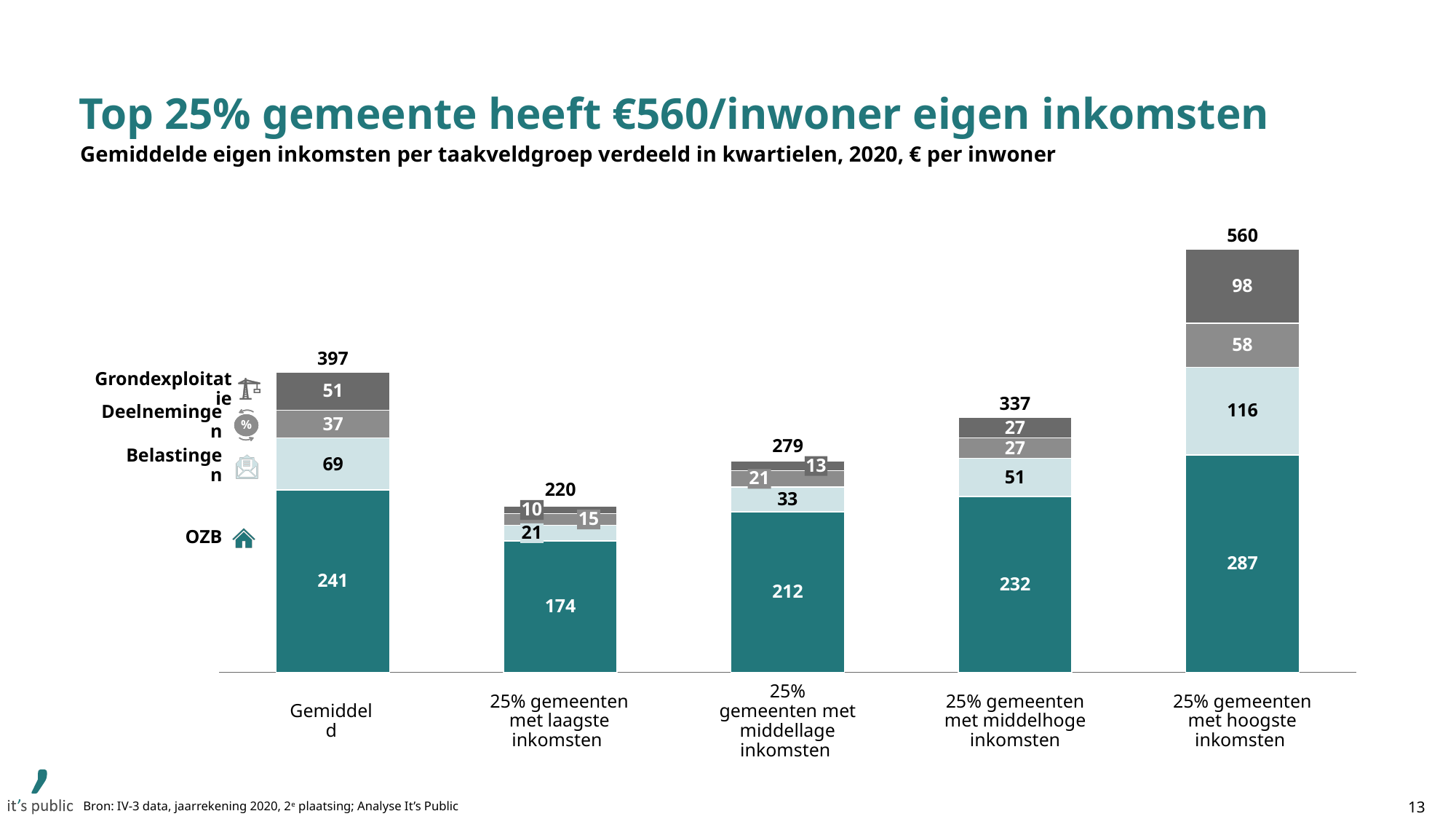
What is the Belastingen value for 'Gemiddeld'? 69 Do the bar totals rise or fall from the lowest-income quartile to the highest-income quartile? Rise Which category has the highest total? 25% gemeenten met hoogste inkomsten How many bars (categories) are shown in the chart? 5 What is the Grondexploitatie value for '25% gemeenten met middellage inkomsten'? 13 What is the difference between the total for '25% gemeenten met hoogste inkomsten' and the total for 'Gemiddeld'? 163 Which category has the lowest total? 25% gemeenten met laagste inkomsten What kind of chart is shown on the slide? Stacked bar chart How many series (taakveldgroepen) does the legend list? 4 What is the total of the bar for '25% gemeenten met middelhoge inkomsten'? 337 What is the OZB value for '25% gemeenten met hoogste inkomsten'? 287 Which is larger: the Deelnemingen value for '25% gemeenten met hoogste inkomsten' or the Grondexploitatie value for the same category? Grondexploitatie (98)